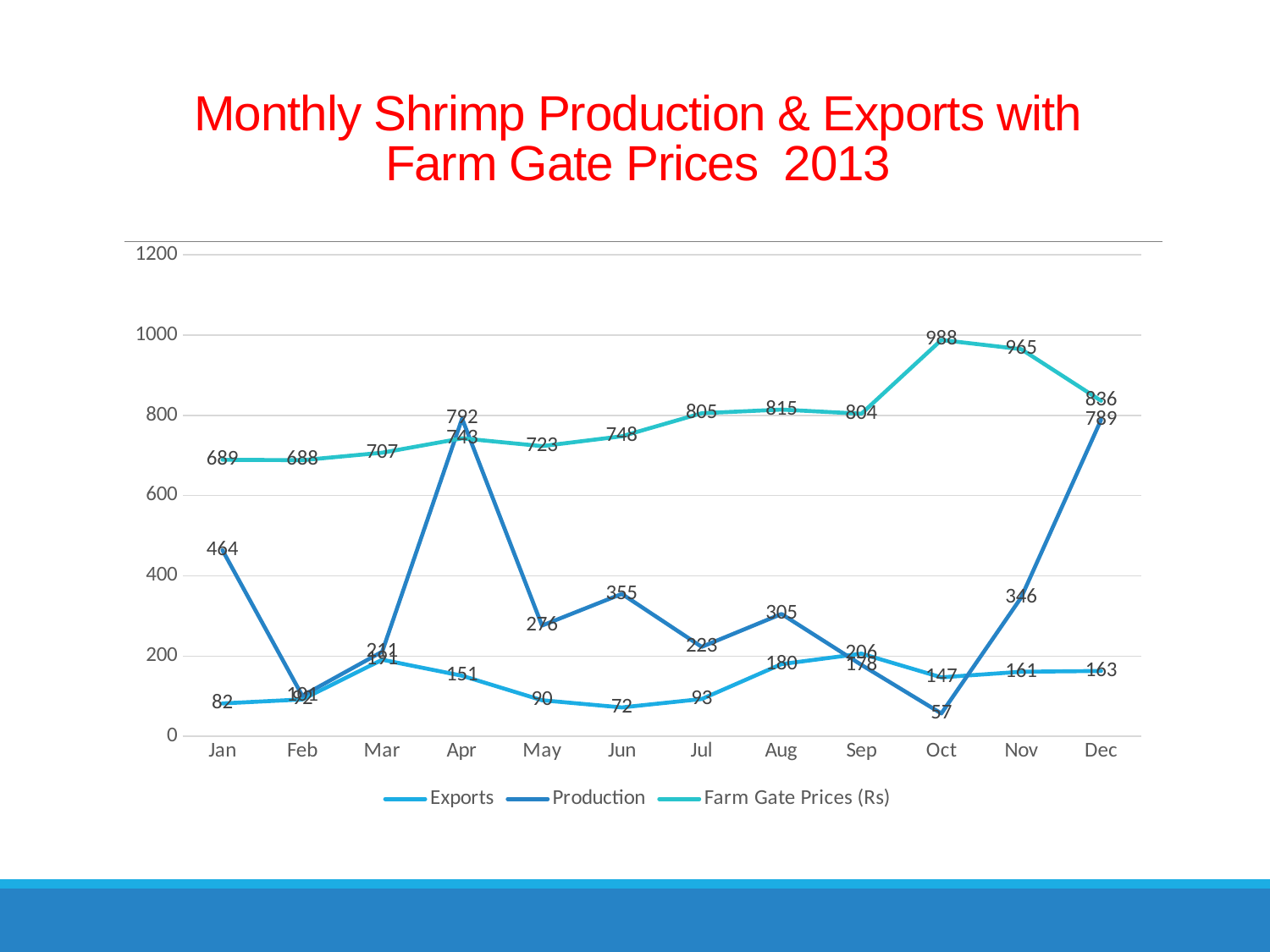
In which month is the Farm Gate Price highest? Oct In which month is Production lowest? Oct What is the Exports value in Aug? 180 How many months are plotted along the x axis? 12 What kind of chart is shown on the slide? line chart What is the difference between the Farm Gate Price in Oct and in Nov? 23 What is the Production value in Oct? 57 In which month are Exports lowest? Jun Which is larger, Production in Jan or Production in Jun? Jan Is the Production value for Apr greater or less than 600? greater How many series does the legend list? 3 What is the Farm Gate Price in Oct? 988